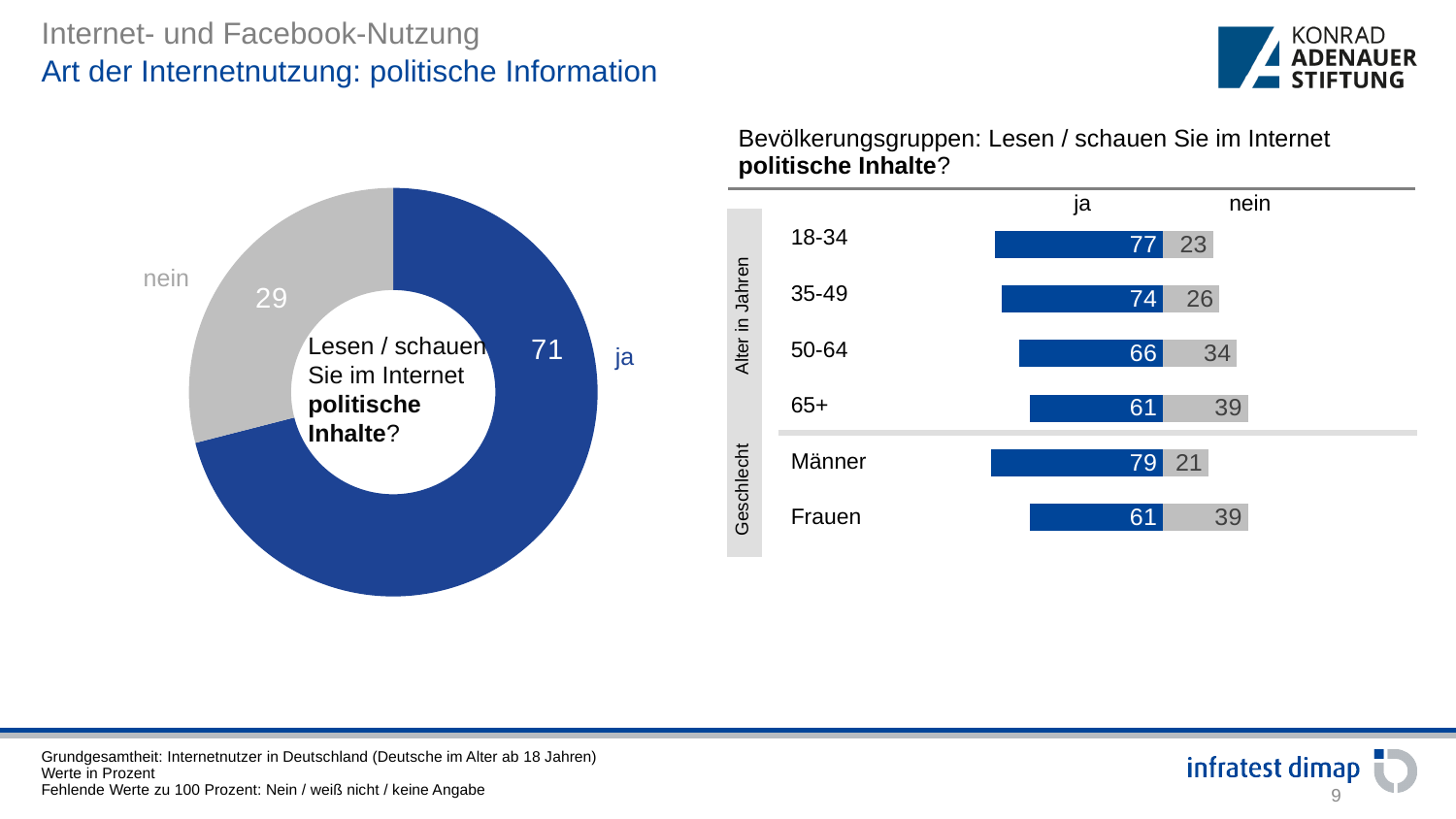
In the bar chart on the right, what is the "nein" value for the 50-64 age group? 34 In the bar chart on the right, which age group has the lowest "ja" value? 65+ In the bar chart on the right, what is the total of the "ja" and "nein" values for the 65+ group? 100 How many groups (bars) are shown in the bar chart on the right? 6 In the bar chart on the right, is the "ja" value larger for 35-49 or for 50-64? 35-49 In the bar chart on the right, how do the "ja" values change as the age groups get older? They fall In the donut chart on the left, what is the value for "nein"? 29 In the donut chart on the left, what is the value for "ja"? 71 What kind of chart is shown on the left side of the slide? Donut (pie) chart In the bar chart on the right, what is the "ja" value for the 18-34 age group? 77 In the bar chart on the right, what is the difference between the "ja" values for Männer and Frauen? 18 In the bar chart on the right, which group has the highest "ja" value? Männer